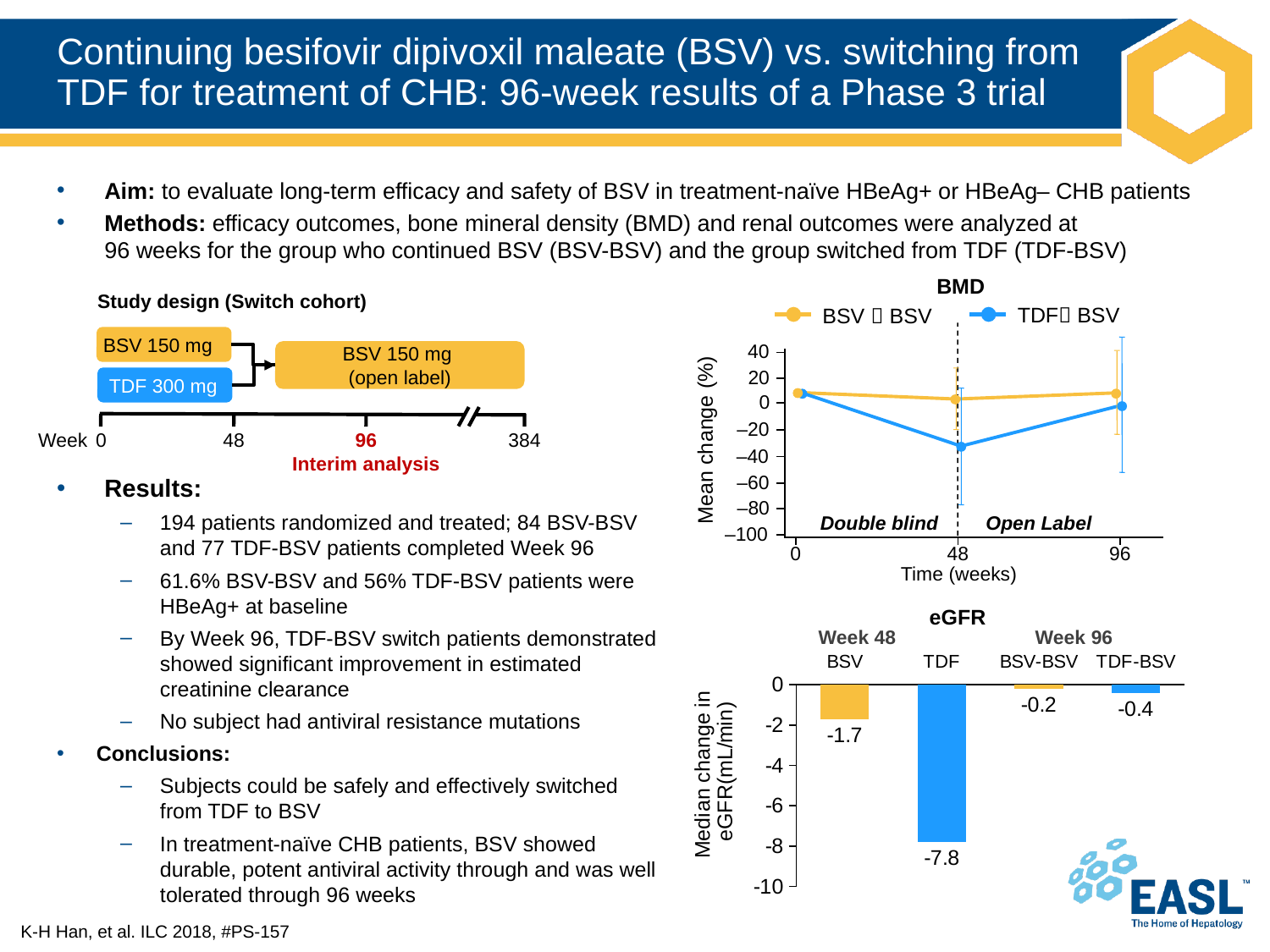
In the eGFR chart, which bar shows the lowest (most negative) median change in eGFR? TDF (Week 48) In the eGFR chart, what is the value for TDF-BSV at Week 96? -0.4 In the eGFR chart, what is the difference between the BSV and TDF values at Week 48? 6.1 What kind of chart is the BMD chart? Line chart In the eGFR chart, what is the value for BSV-BSV at Week 96? -0.2 In the BMD chart, which series has the lower mean change at week 48, BSV→BSV or TDF→BSV? TDF→BSV In the eGFR chart, what is the median change in eGFR for TDF at Week 48? -7.8 In the BMD chart, how many series does the legend list? 2 In the eGFR chart, how many bars are plotted? 4 In the BMD chart, is the mean change for TDF→BSV at week 48 greater or less than -20? less In the eGFR chart, what is the median change in eGFR for BSV at Week 48? -1.7 What kind of chart is the eGFR chart? Bar chart